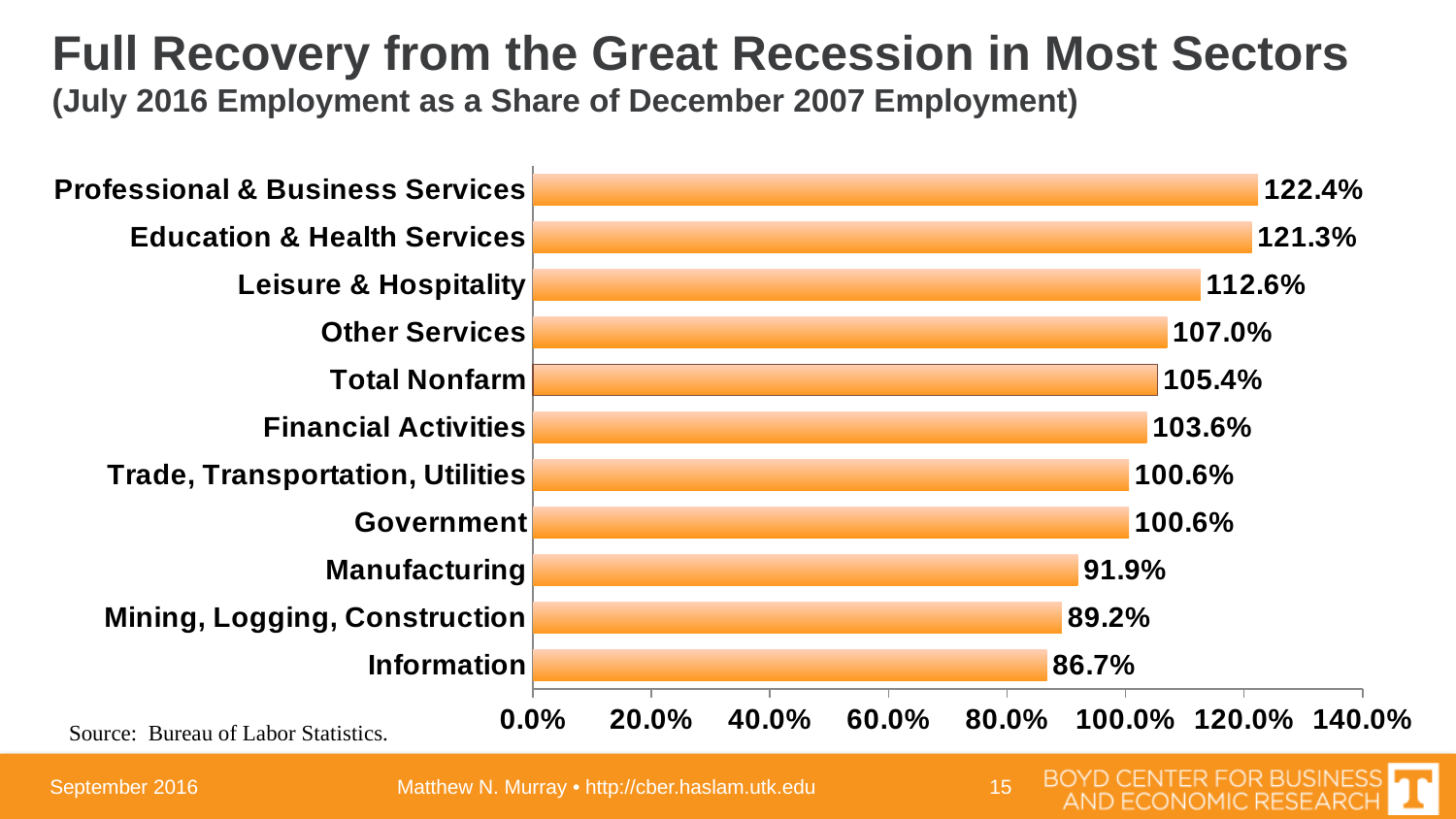
Which category has the lowest value? Information Which category has the highest value? Professional & Business Services How many categories are shown in the chart? 11 What is the value for Manufacturing? 91.9% What is the value for Total Nonfarm? 105.4% What kind of chart is shown on the slide? bar chart What is the source cited for the chart data? Bureau of Labor Statistics What is the value for Professional & Business Services? 122.4% Is the value for Mining, Logging, Construction greater or less than 100.0%? less What is the difference between the values for Leisure & Hospitality and Other Services? 5.6% What is the difference between the values for Professional & Business Services and Information? 35.7% Which is larger, the value for Financial Activities or the value for Manufacturing? Financial Activities